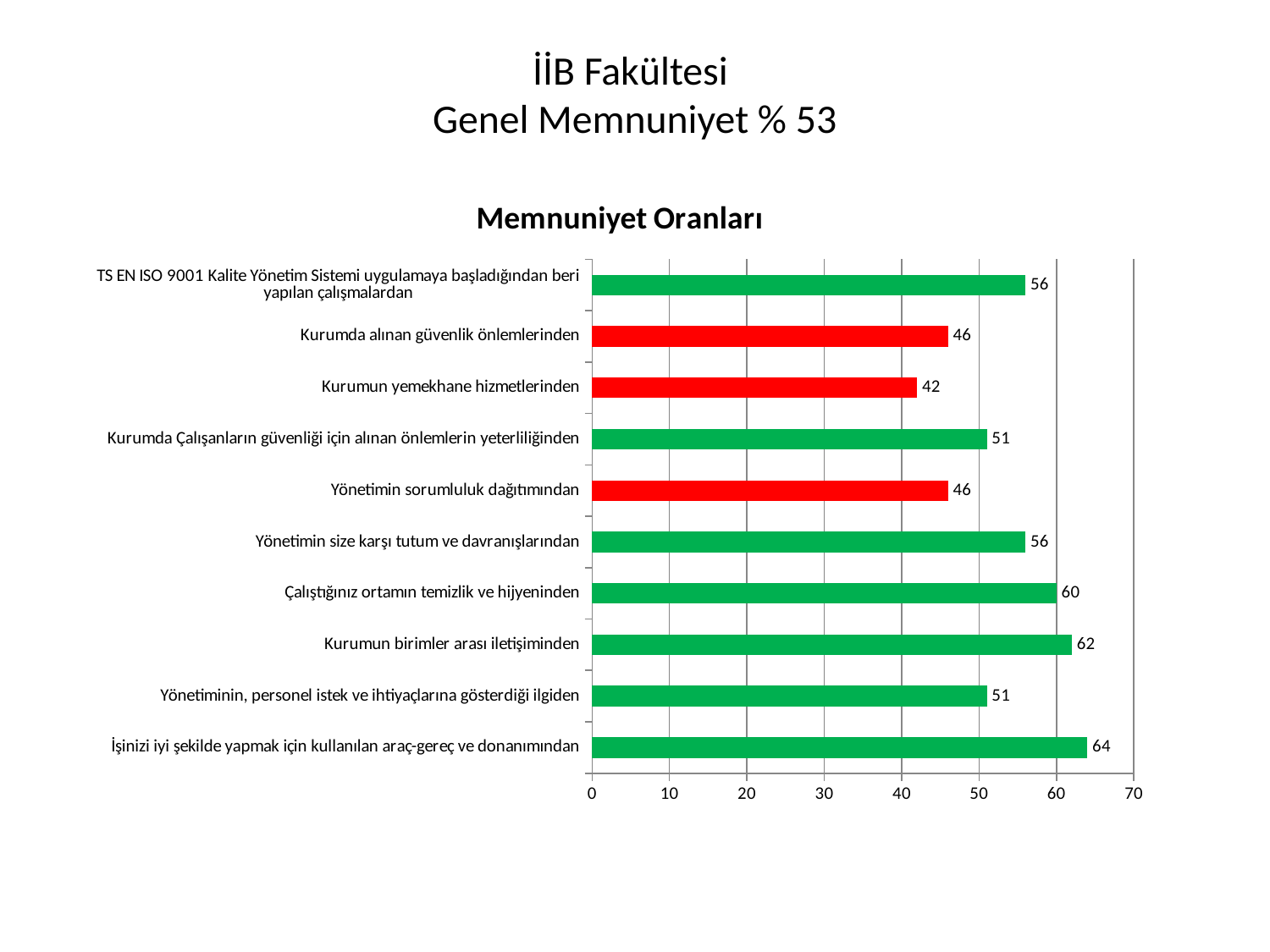
What is the value for 'Kurumun yemekhane hizmetlerinden'? 42 Is the value for 'Yönetimin sorumluluk dağıtımından' greater or less than 50? less Which category has the lowest value? Kurumun yemekhane hizmetlerinden Which category has the highest value? İşinizi iyi şekilde yapmak için kullanılan araç-gereç ve donanımından What is the difference between the values for 'İşinizi iyi şekilde yapmak için kullanılan araç-gereç ve donanımından' and 'Kurumun yemekhane hizmetlerinden'? 22 What is the value for 'Çalıştığınız ortamın temizlik ve hijyeninden'? 60 What is the title of the chart? Memnuniyet Oranları What kind of chart is shown on the slide? bar chart What is the value for 'Kurumun birimler arası iletişiminden'? 62 How many categories are shown in the chart? 10 How many bars are coloured red? 3 Which is larger: the value for 'Kurumda alınan güvenlik önlemlerinden' or the value for 'Kurumda Çalışanların güvenliği için alınan önlemlerin yeterliliğinden'? Kurumda Çalışanların güvenliği için alınan önlemlerin yeterliliğinden